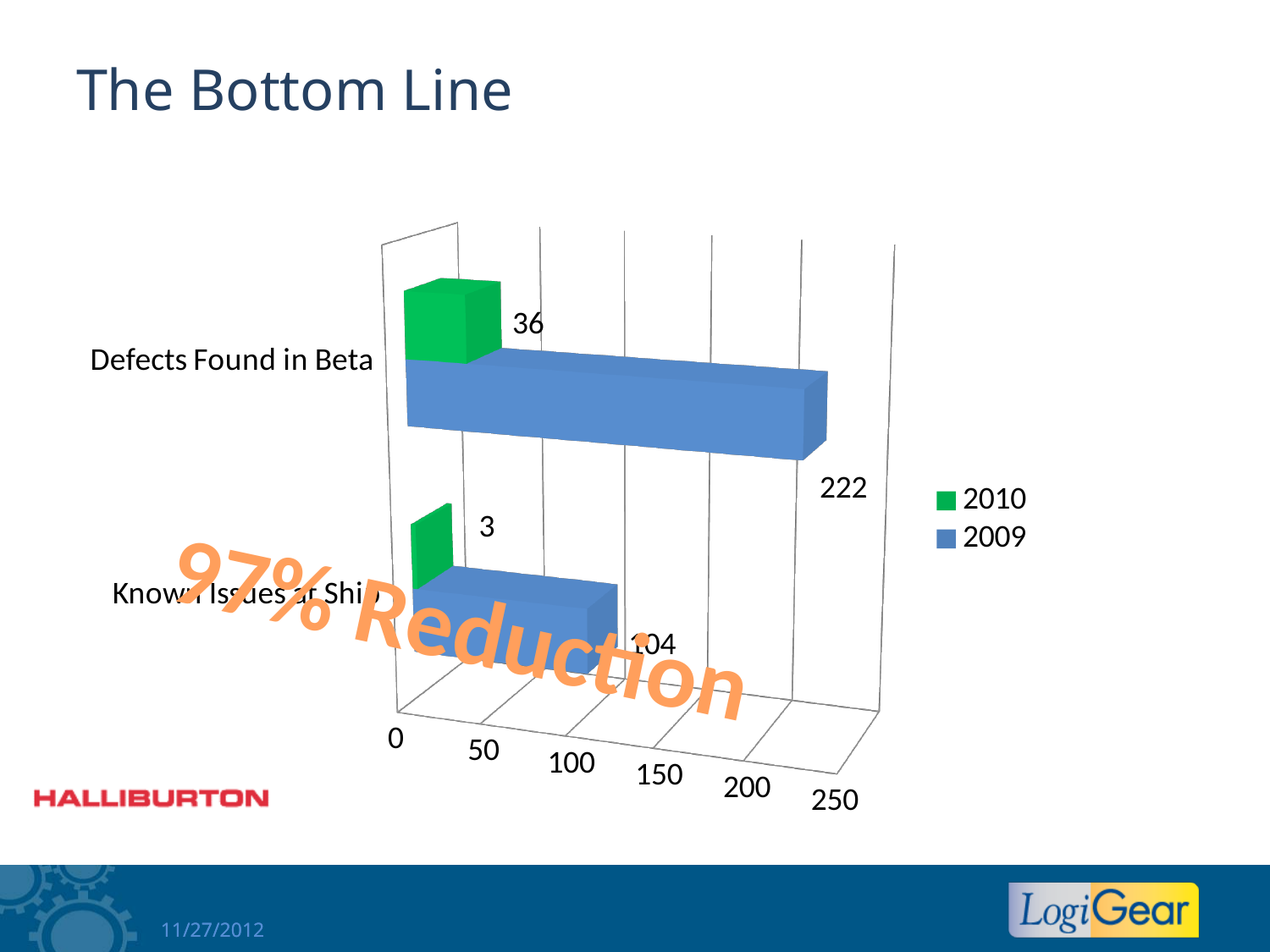
Which series has the larger value for Defects Found in Beta, 2009 or 2010? 2009 What is the 2010 value for Known Issues at Ship? 3 Which category has the lowest 2010 value? Known Issues at Ship What is the difference between the 2009 and 2010 values for Defects Found in Beta? 186 What is the 2009 value for Defects Found in Beta? 222 What is the 2010 value for Defects Found in Beta? 36 What text is overlaid in orange across the chart? 97% Reduction What kind of chart is shown on the slide? Bar chart Which category has the highest 2009 value? Defects Found in Beta How many series does the legend list? 2 How many categories are shown on the chart? 2 What is the 2009 value for Known Issues at Ship? 104